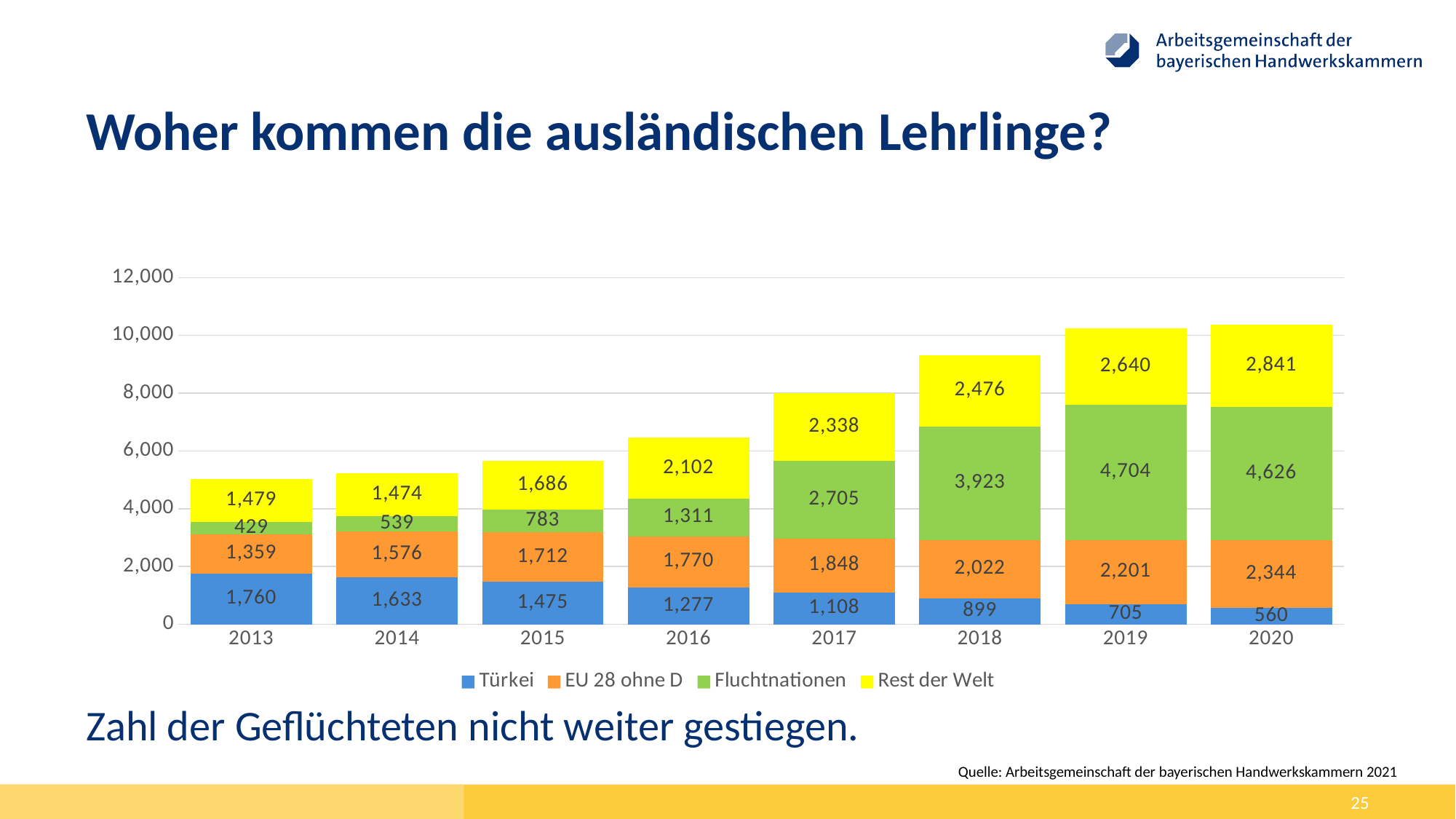
Which is larger in 2015: the value for EU 28 ohne D or the value for Rest der Welt? EU 28 ohne D What is the difference between the Fluchtnationen values in 2018 and 2017? 1,218 What is the value for Fluchtnationen in 2019? 4,704 What is the value for Türkei in 2013? 1,760 How many series does the legend list? 4 What is the total of the stacked bar for 2013? 5,027 What is the value for Rest der Welt in 2020? 2,841 What kind of chart is shown on the slide? Stacked bar chart Does the Türkei value rise or fall from 2013 to 2020? Fall In which year is the Fluchtnationen value highest? 2019 What is the value for EU 28 ohne D in 2016? 1,770 In which year is the Türkei value lowest? 2020